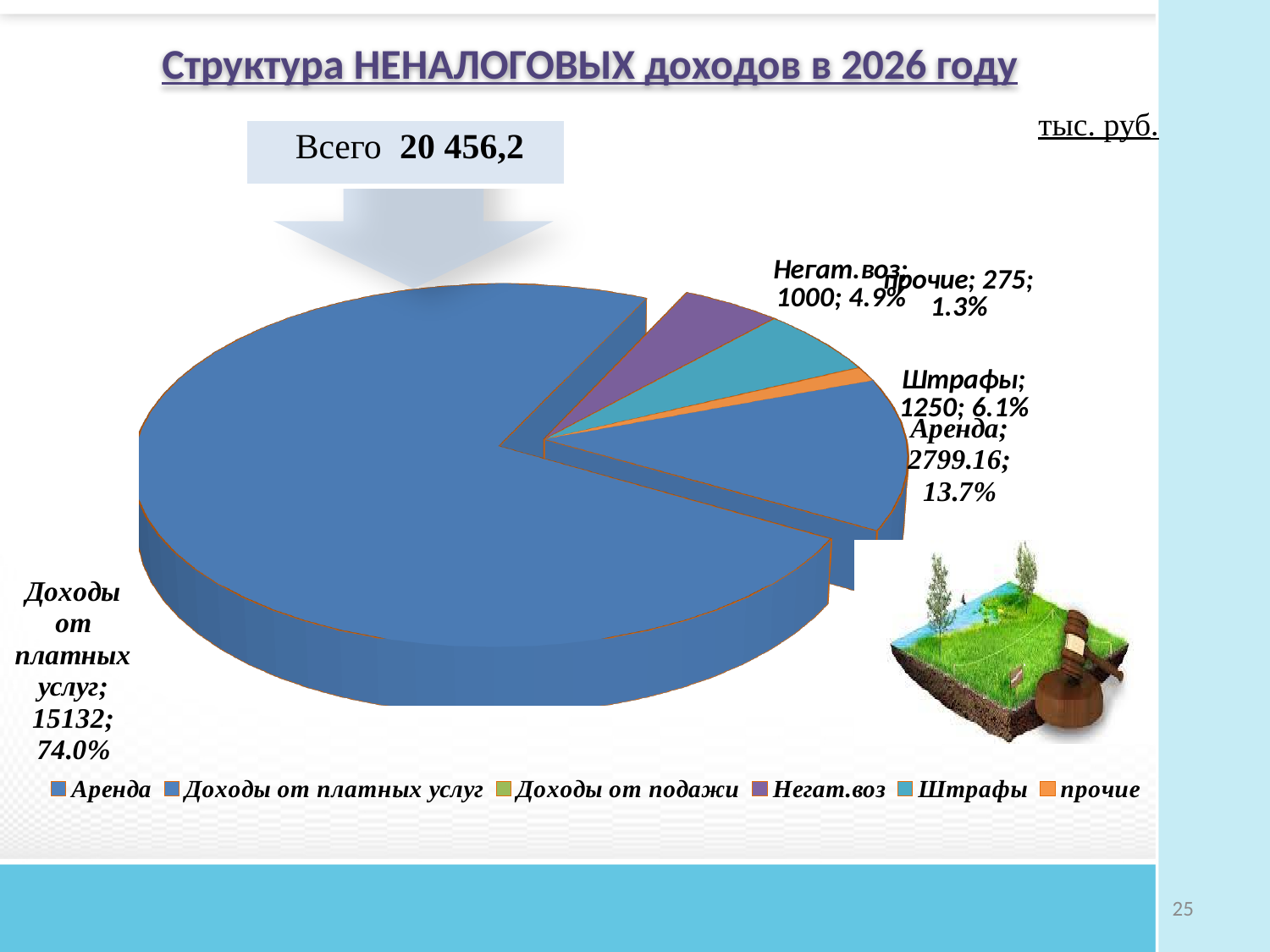
What is the difference between the values for Штрафы and Негат.воз? 250 What share of the pie does Доходы от платных услуг represent? 74.0% What share of the pie does Аренда represent? 13.7% Which category has the largest slice of the pie? Доходы от платных услуг What kind of chart is shown on the slide? pie chart Which labelled category has the smallest slice of the pie? прочие What is the value for прочие? 275 What share of the pie does Негат.воз represent? 4.9% What is the value for Аренда? 2799.16 What is the value for Штрафы? 1250 What is the value for Доходы от платных услуг? 15132 How many entries does the legend list? 6